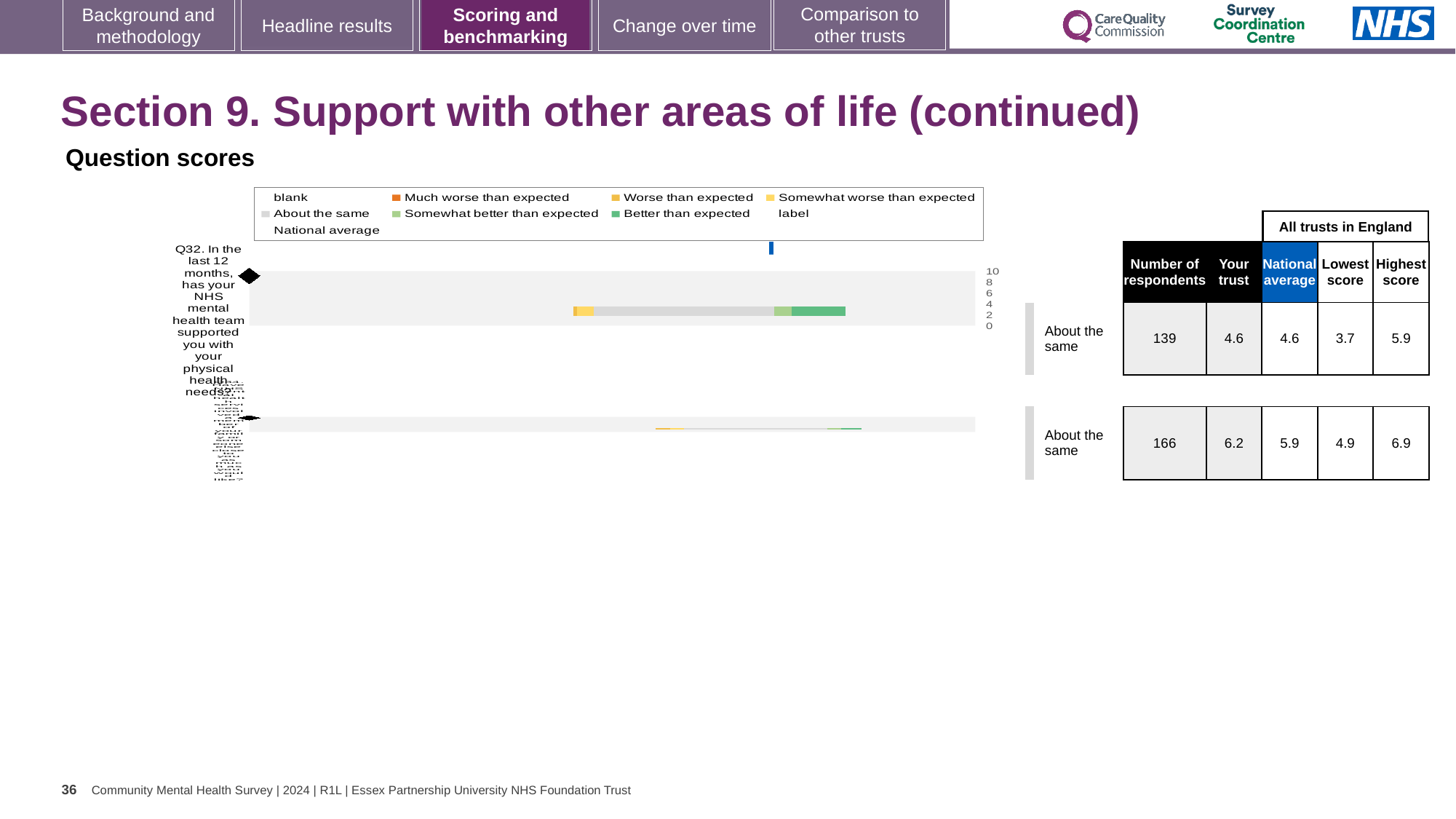
What is the lowest score among all trusts in England for Q32? 3.7 How many respondents answered Q32? 139 What benchmark category is the trust's Q32 score placed in? About the same What is the highest score among all trusts in England for Q32? 5.9 What is the 'Your trust' score in the second row of the table? 6.2 In the second row of the table, is the 'Your trust' score or the national average higher? Your trust Which legend entry is shown in dark green? Better than expected What is the national average score for Q32? 4.6 What is the maximum value shown on the chart's score axis? 10 What is the difference between the highest and lowest trust scores for Q32? 2.2 What is the 'Your trust' score for Q32 (support with physical health needs)? 4.6 What type of chart is shown on the slide? bar chart